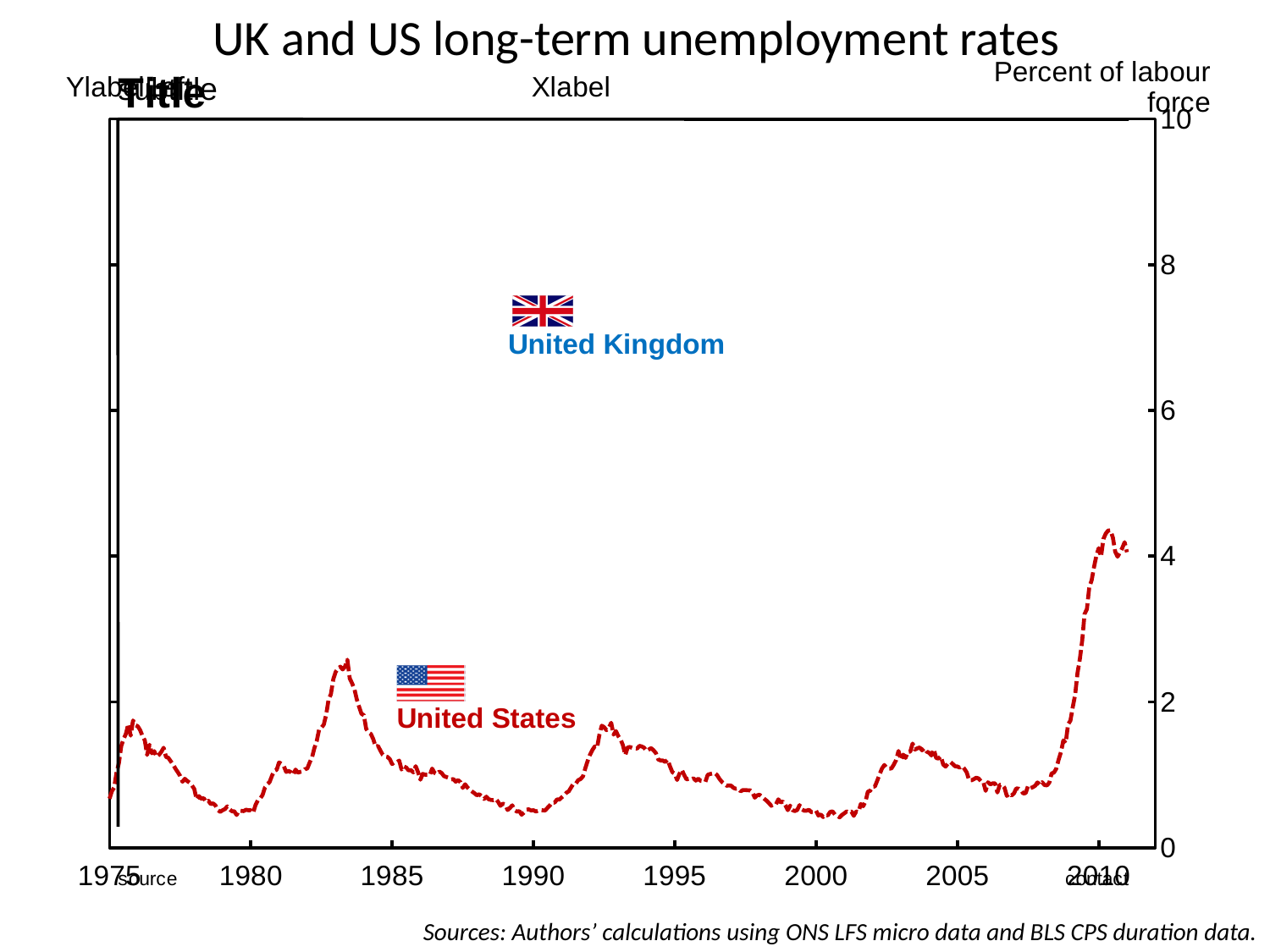
What is the highest value shown on the y axis? 10 Does the United States long-term unemployment rate rise or fall between 2008 and 2010? rise What kind of chart is shown on the slide? line chart How many year labels are shown along the x axis? 8 Does the United States long-term unemployment rate rise or fall between 1983 and 1990? fall Is the United States long-term unemployment rate higher around 2010 or around 1983? around 2010 In what units are the values on the chart expressed, according to the label above the right-hand axis? Percent of labour force Is the United States long-term unemployment rate at its peak around 2010 greater or less than 4? greater What is the title of the chart? UK and US long-term unemployment rates Is the United States long-term unemployment rate at its peak around 1983 greater or less than 2? greater Is the United States long-term unemployment rate around 2000 greater or less than 1? less